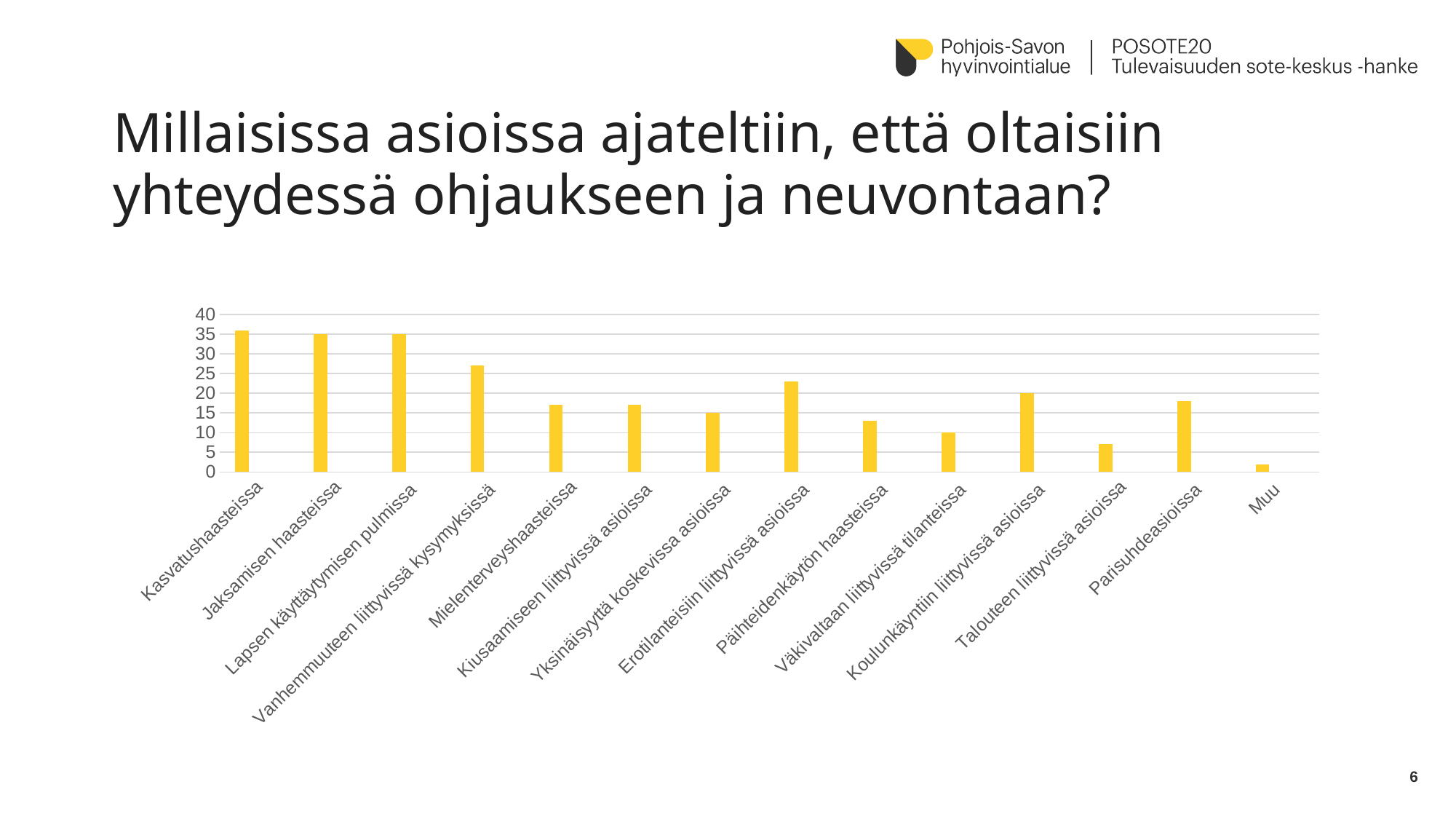
What kind of chart is shown on the slide? bar chart Is the value for Päihteidenkäytön haasteissa greater or less than 15? less Is the value for Vanhemmuuteen liittyvissä kysymyksissä greater or less than 25? greater What colour are the bars in the chart? yellow Which is larger, the value for Vanhemmuuteen liittyvissä kysymyksissä or the value for Erotilanteisiin liittyvissä asioissa? Vanhemmuuteen liittyvissä kysymyksissä Is the value for Talouteen liittyvissä asioissa greater or less than 10? less How many categories are shown on the x axis of the chart? 14 Which category has the lowest value in the chart? Muu Which is larger, the value for Parisuhdeasioissa or the value for Talouteen liittyvissä asioissa? Parisuhdeasioissa